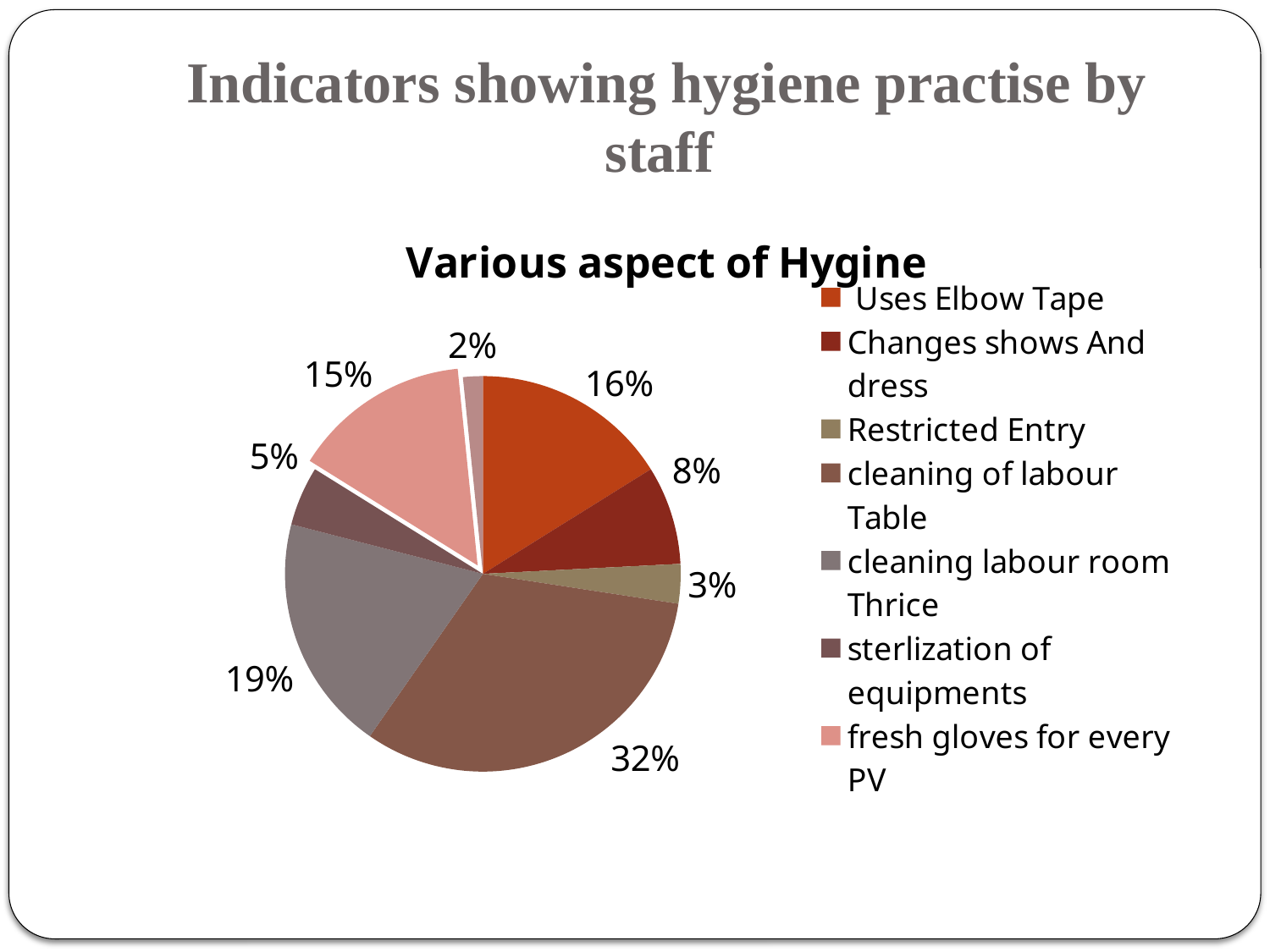
What is the difference in percentage points between cleaning of labour Table and Uses Elbow Tape? 16 What percentage is shown for sterlization of equipments? 5% Which category has the largest slice of the pie? cleaning of labour Table What percentage is shown for cleaning of labour Table? 32% What is the title of the chart? Various aspect of Hygine What percentage is shown for fresh gloves for every PV? 15% What percentage is shown for Uses Elbow Tape? 16% Which is larger, the slice for cleaning labour room Thrice or the slice for Changes shows And dress? cleaning labour room Thrice What percentage is shown for Restricted Entry? 3% How many slices does the pie chart have? 8 How many entries does the legend list? 7 What type of chart is shown on the slide? pie chart